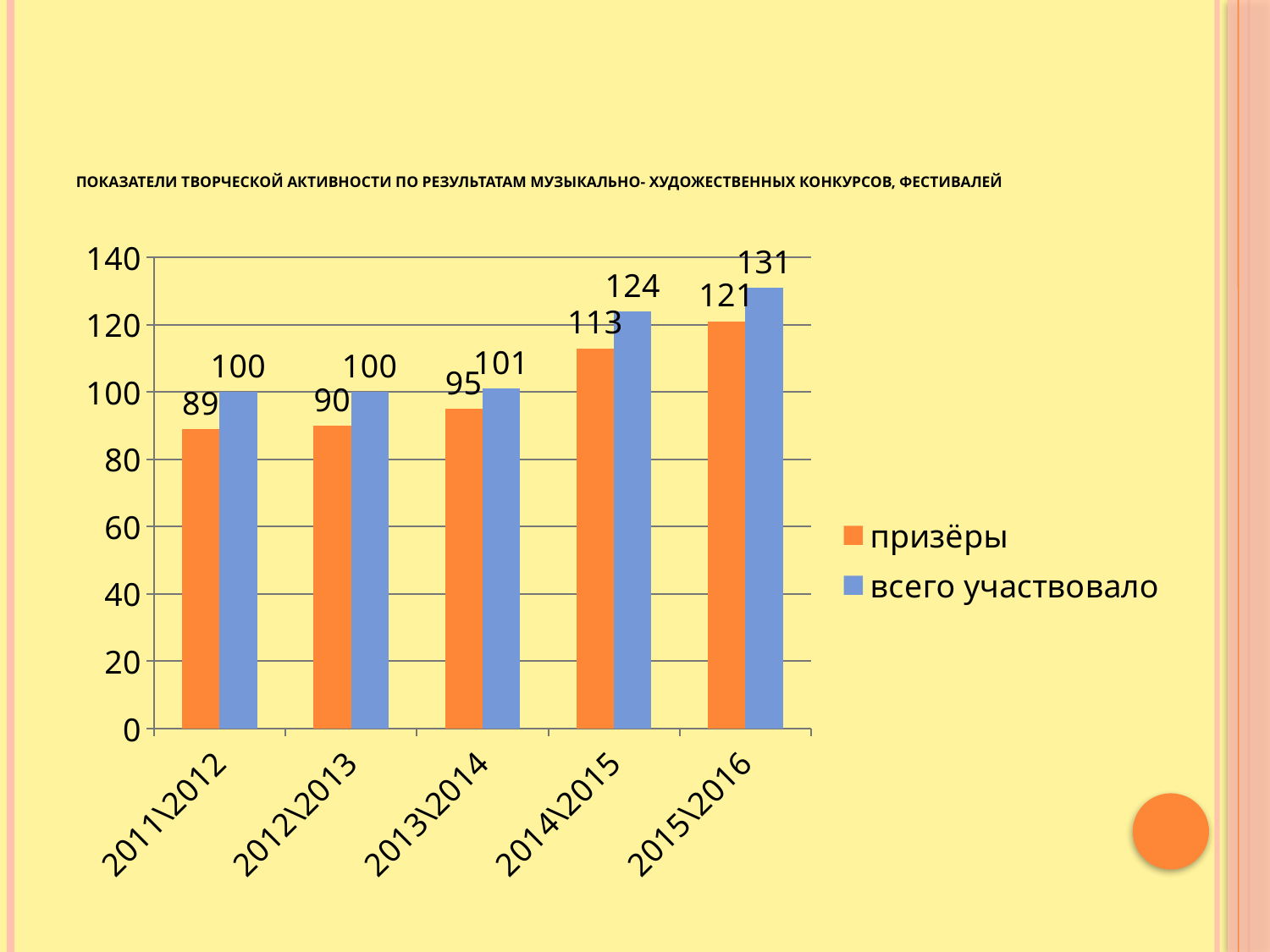
What is the value for призёры in 2014\2015? 113 What is the difference between всего участвовало and призёры in 2014\2015? 11 In which year is the value for призёры lowest? 2011\2012 How many series does the legend list? 2 What is the value for всего участвовало in 2013\2014? 101 In which year is the value for призёры highest? 2015\2016 What is the value for призёры in 2011\2012? 89 Which is larger: призёры in 2012\2013 or призёры in 2013\2014? призёры in 2013\2014 How many years are shown on the x axis? 5 Do the values for всего участвовало rise or fall from 2011\2012 to 2015\2016? rise What is the value for всего участвовало in 2015\2016? 131 What kind of chart is shown on the slide? bar chart